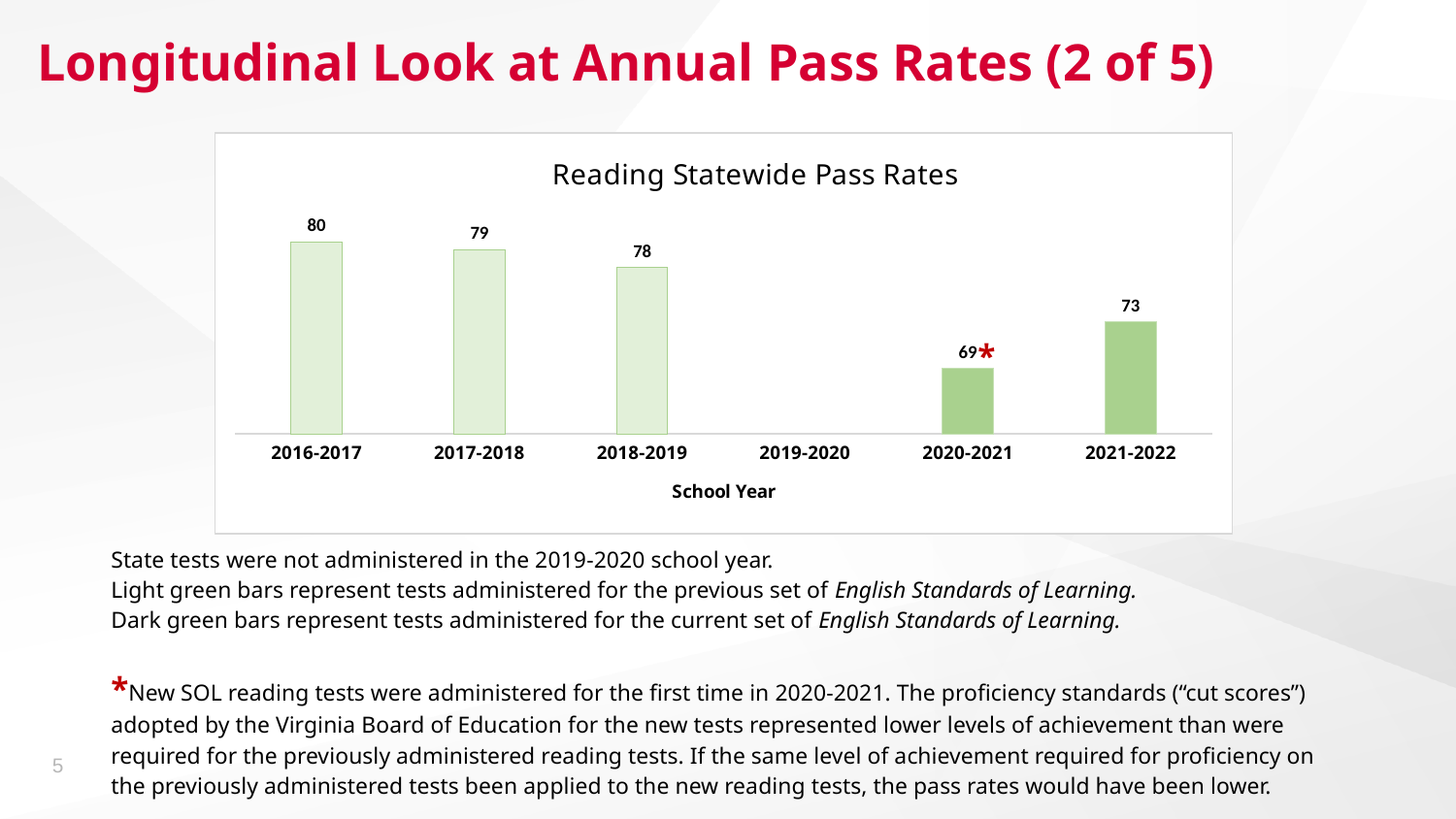
Which is larger, the pass rate for 2018-2019 or for 2021-2022? 2018-2019 Which school year with a plotted bar has the lowest reading statewide pass rate? 2020-2021 What is the reading statewide pass rate for 2016-2017? 80 What is the reading statewide pass rate for 2020-2021? 69 How many school years are shown on the x axis? 6 What is the reading statewide pass rate for 2021-2022? 73 What is the title of the chart? Reading Statewide Pass Rates What is the difference between the pass rates for 2016-2017 and 2020-2021? 11 What kind of chart is shown on the slide? Bar chart Which school year has the highest reading statewide pass rate? 2016-2017 What is the difference between the pass rates for 2021-2022 and 2020-2021? 4 Do the pass rates rise or fall from 2016-2017 to 2018-2019? Fall